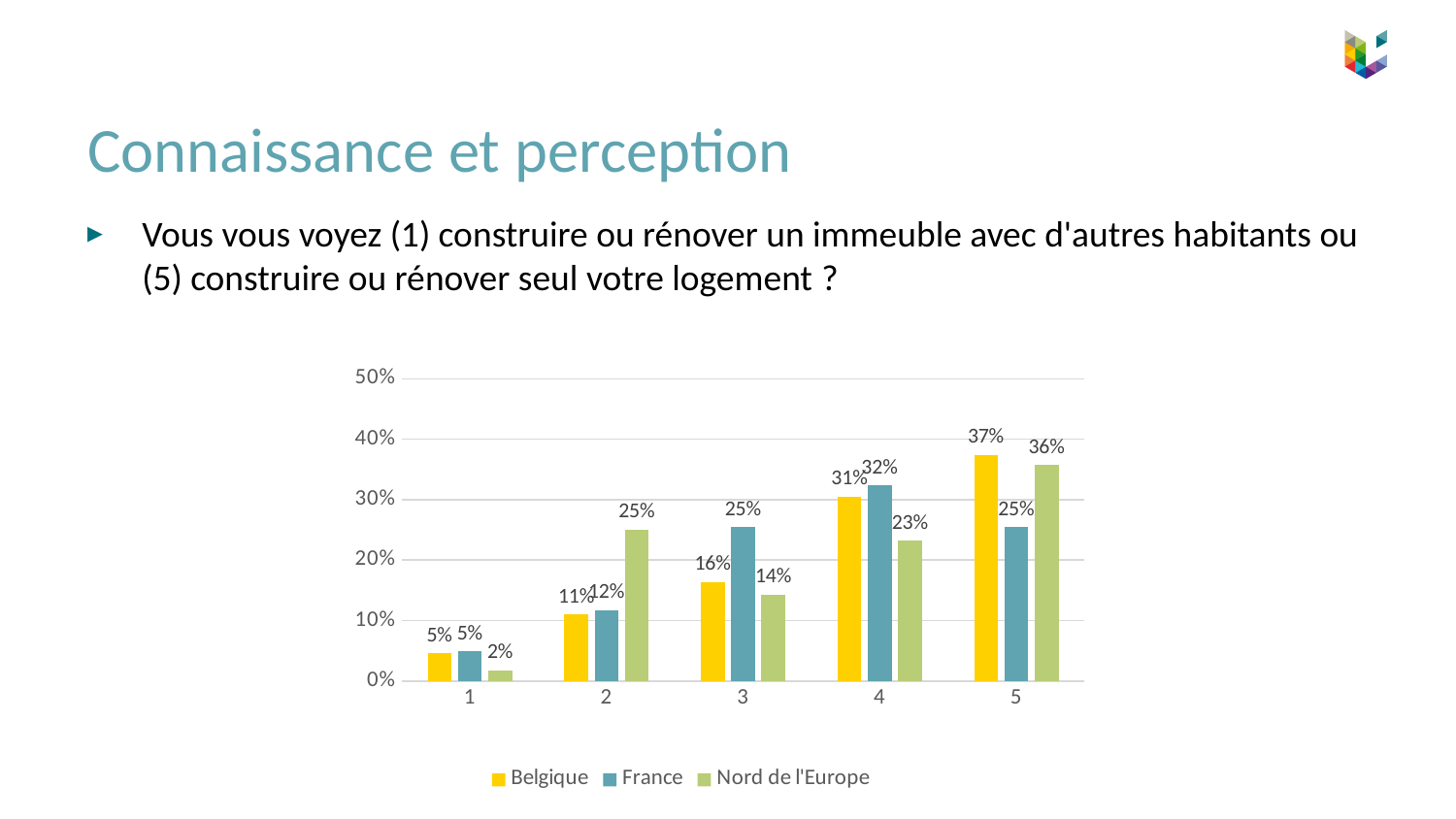
What is the difference between the Belgique and France values at category 5? 12% What is the value for Belgique at category 5? 37% What is the value for Nord de l'Europe at category 2? 25% At category 3, which is larger: the value for France or the value for Nord de l'Europe? France How many series does the legend list? 3 What type of chart is shown on the slide? bar chart How many categories are shown on the x axis? 5 Which category has the lowest value for Nord de l'Europe? 1 What is the value for France at category 3? 25% Which category has the highest value for France? 4 Which series is shown in yellow in the legend? Belgique Do the Belgique values rise or fall from category 1 to category 5? rise